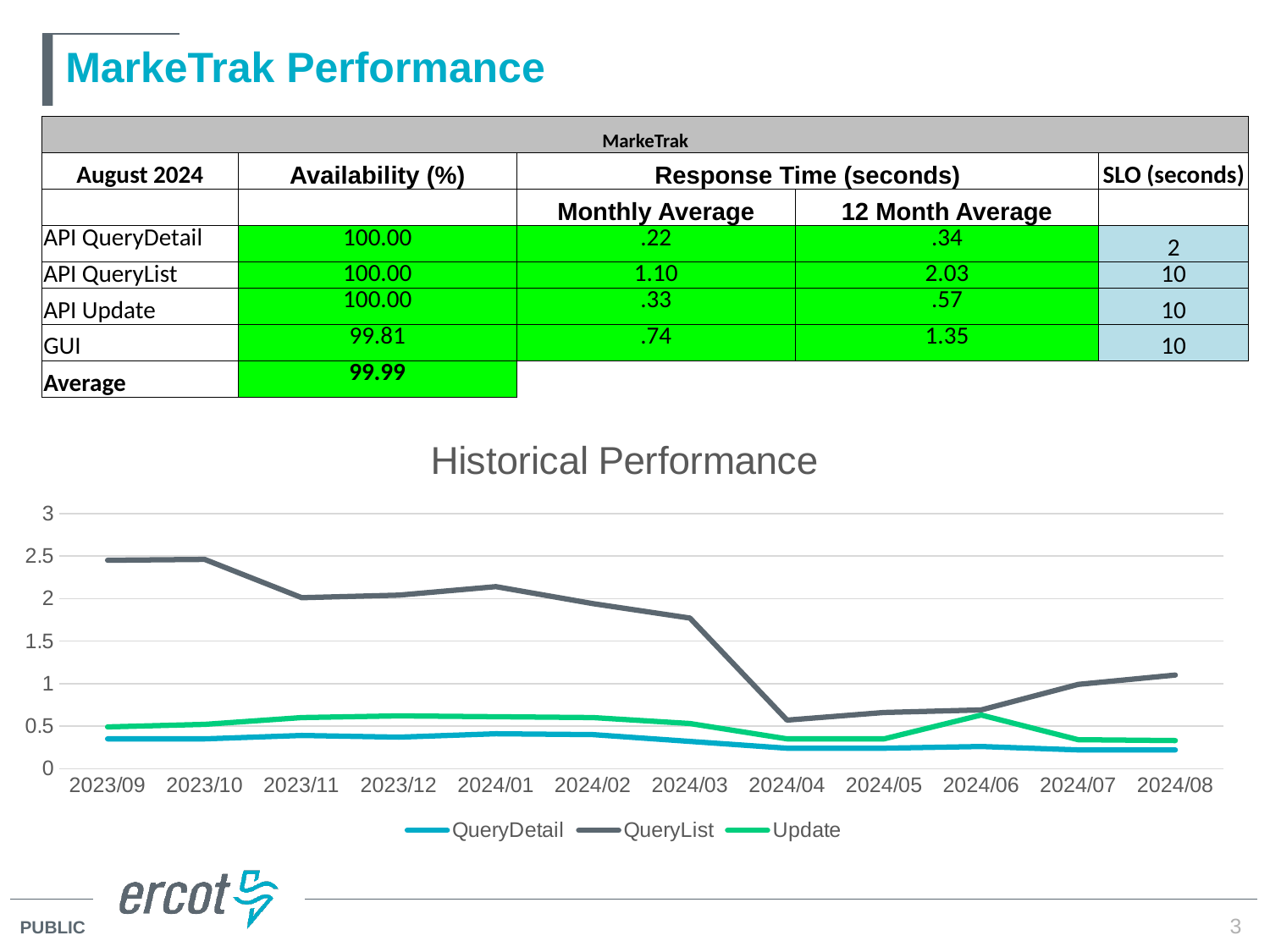
How many series does the legend of the Historical Performance chart list? 3 In the Historical Performance chart, is the QueryList value for 2024/04 greater or less than 1? less In the Historical Performance chart, is the Update value for 2024/06 greater or less than 0.5? greater In the Historical Performance chart, does the QueryList line generally rise or fall from 2023/09 to 2024/08? fall How many months are plotted along the x axis of the Historical Performance chart? 12 What kind of chart is the Historical Performance chart? line chart What is the title of the chart on the slide? Historical Performance In the Historical Performance chart, is the QueryList value for 2023/09 greater or less than 2? greater Which series in the Historical Performance chart is drawn in dark gray? QueryList In the Historical Performance chart, which series has the highest value at 2023/09? QueryList In the Historical Performance chart, which is larger at 2024/01: QueryList or Update? QueryList